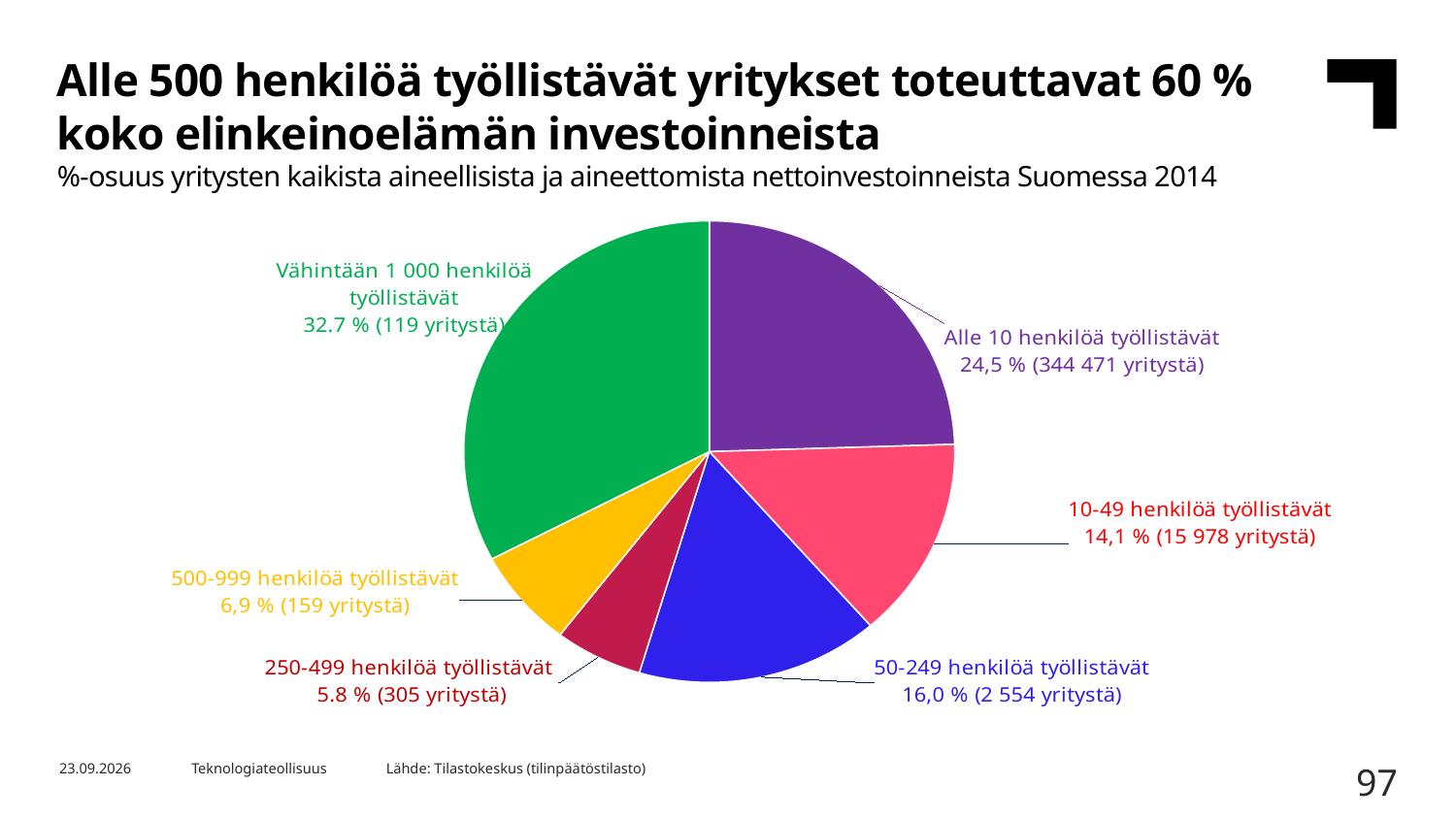
What colour is the slice for 50-249 henkilöä työllistävät? Blue Which category has the largest share of the pie? Vähintään 1 000 henkilöä työllistävät What is the difference in percentage points between the share of Alle 10 henkilöä työllistävät and 10-49 henkilöä työllistävät? 10,4 percentage points What share of net investments is attributed to companies employing fewer than 10 people (Alle 10 henkilöä työllistävät)? 24,5 % How many companies are in the 500-999 henkilöä työllistävät category? 159 How many companies are in the 10-49 henkilöä työllistävät category? 15 978 What share of net investments is attributed to companies employing 50-249 people? 16,0 % Which category has the smallest share of the pie? 250-499 henkilöä työllistävät How many slices does the pie chart have? 6 What kind of chart is shown on the slide? Pie chart What share of net investments is attributed to companies employing at least 1 000 people (Vähintään 1 000 henkilöä työllistävät)? 32.7 % Which has a larger share: 500-999 henkilöä työllistävät or 250-499 henkilöä työllistävät? 500-999 henkilöä työllistävät